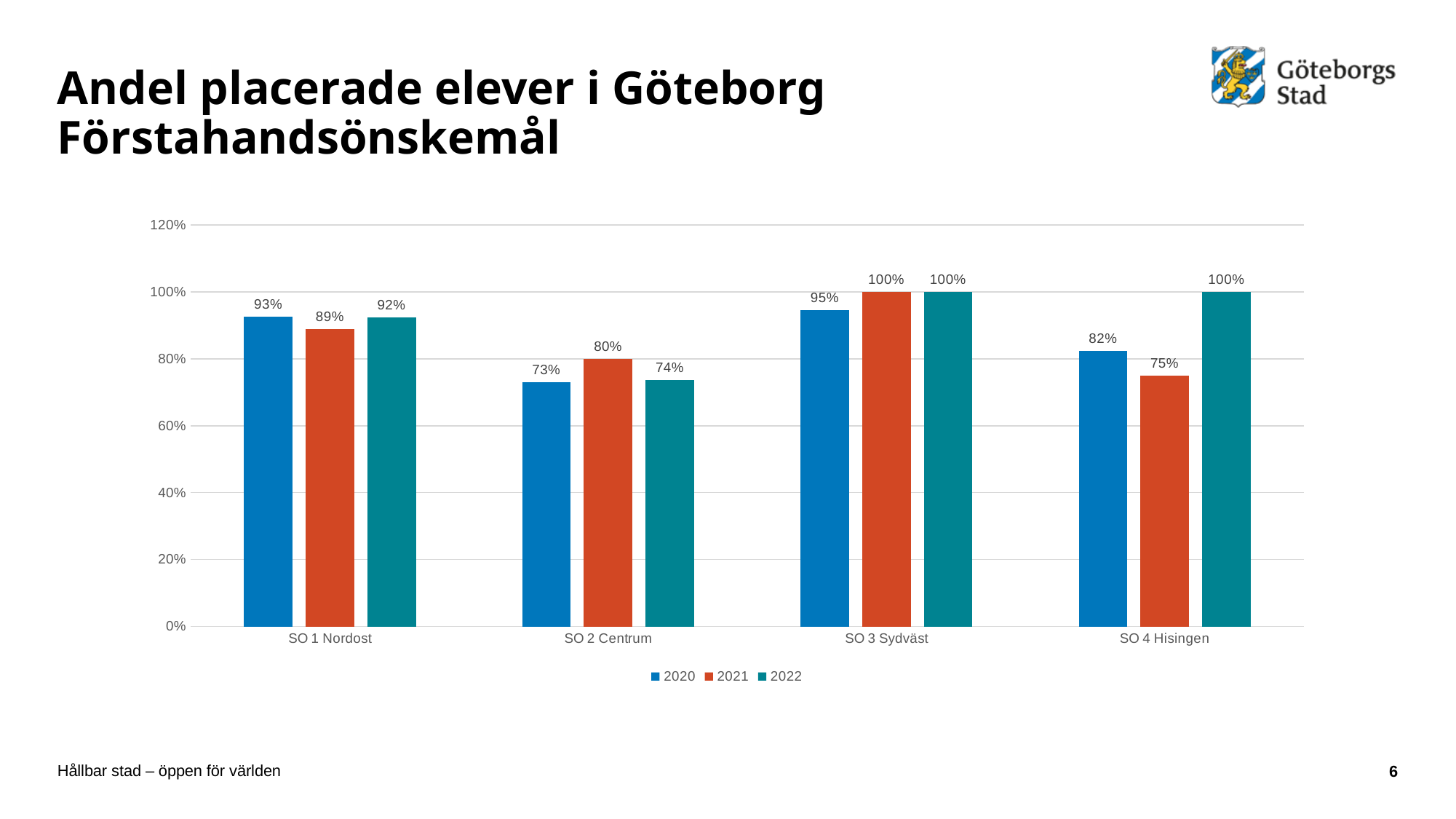
How many series does the legend list? 3 Is the value for SO 2 Centrum in 2022 greater or less than 80%? less What is the value for SO 4 Hisingen in 2022? 100% What is the value for SO 1 Nordost in 2020? 93% What kind of chart is shown on the slide? bar chart How many categories are shown on the x axis? 4 What is the difference between the 2022 and 2021 values for SO 4 Hisingen? 25% Which is larger for SO 1 Nordost: the 2020 value or the 2021 value? 2020 Which category has the highest value for 2021? SO 3 Sydväst What is the value for SO 2 Centrum in 2021? 80% Which category has the lowest value for 2020? SO 2 Centrum What is the value for SO 3 Sydväst in 2020? 95%